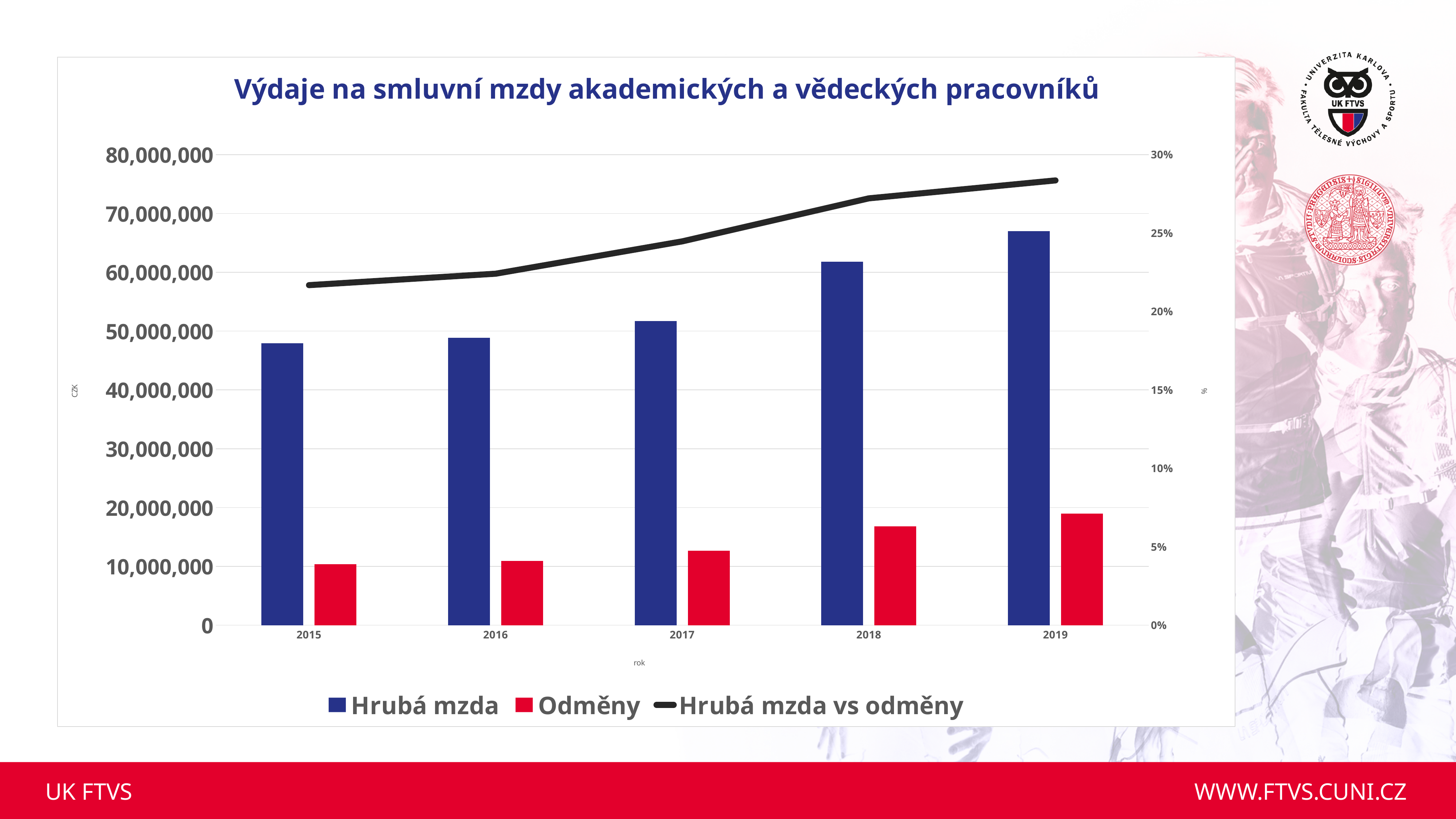
How many series does the legend list? 3 What is the title of the chart? Výdaje na smluvní mzdy akademických a vědeckých pracovníků Is the Hrubá mzda value for 2015 greater or less than 50,000,000? less Which is larger, the Hrubá mzda bar for 2017 or the Hrubá mzda bar for 2018? 2018 Which year has the lowest Odměny bar? 2015 Does the Hrubá mzda vs odměny line rise or fall from 2015 to 2019? rises What kind of chart is shown on the slide? Combined bar and line chart Is the Hrubá mzda value for 2018 greater or less than 60,000,000? greater Is the Odměny value for 2019 greater or less than 20,000,000? less Which year has the highest Hrubá mzda bar? 2019 How many years are shown on the x axis? 5